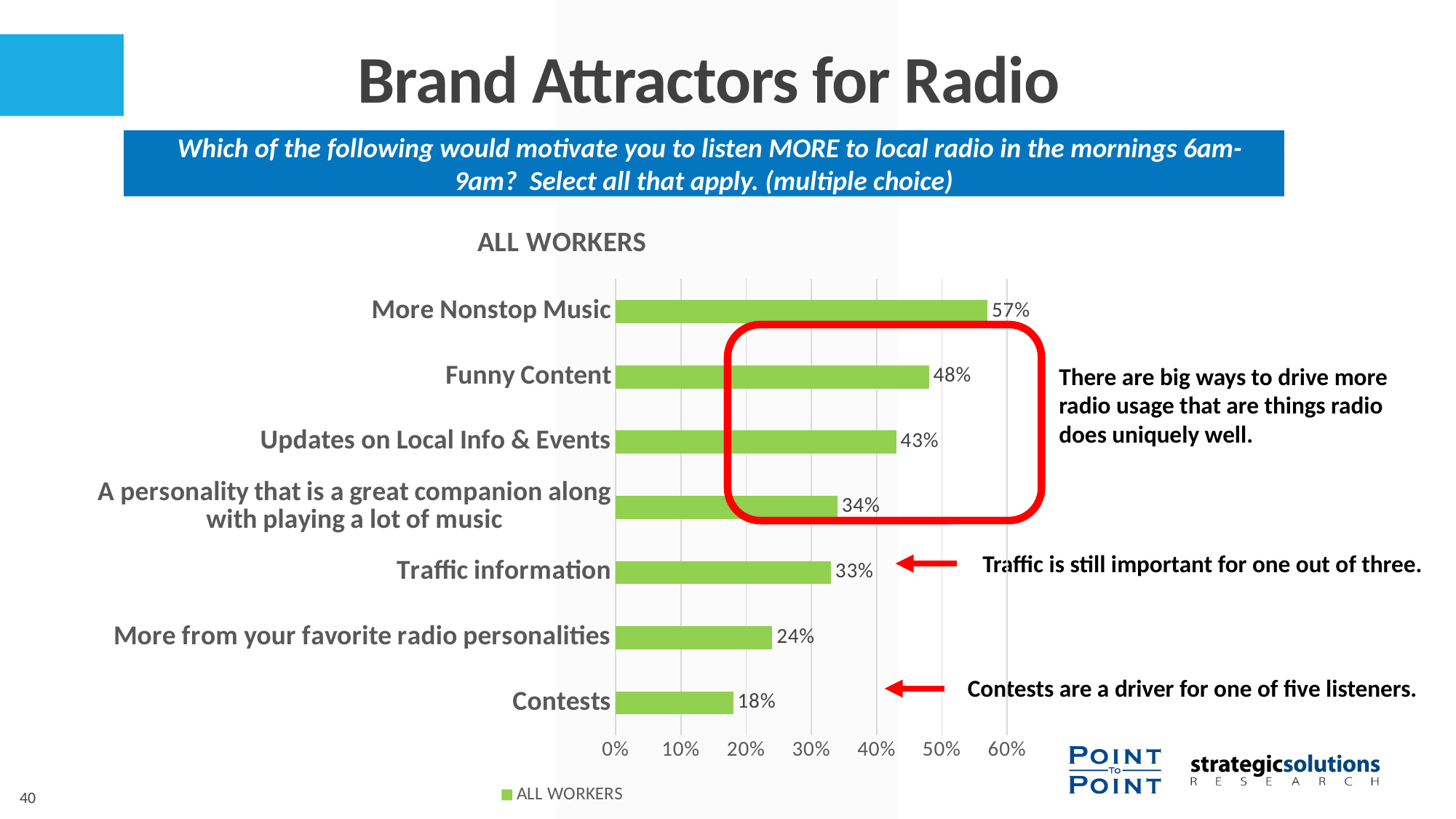
Which is larger: the value for Updates on Local Info & Events or the value for More from your favorite radio personalities? Updates on Local Info & Events What is the value for Contests? 18% How many series does the legend list? 1 Which category has the highest value? More Nonstop Music What is the title of the chart? ALL WORKERS What kind of chart is shown on the slide? Bar chart What is the value for Funny Content? 48% Which category has the lowest value? Contests What is the value for Traffic information? 33% How many categories are shown in the chart? 7 What percentage of all workers said More Nonstop Music would motivate them to listen more? 57% What is the difference between the values for More Nonstop Music and Funny Content? 9%